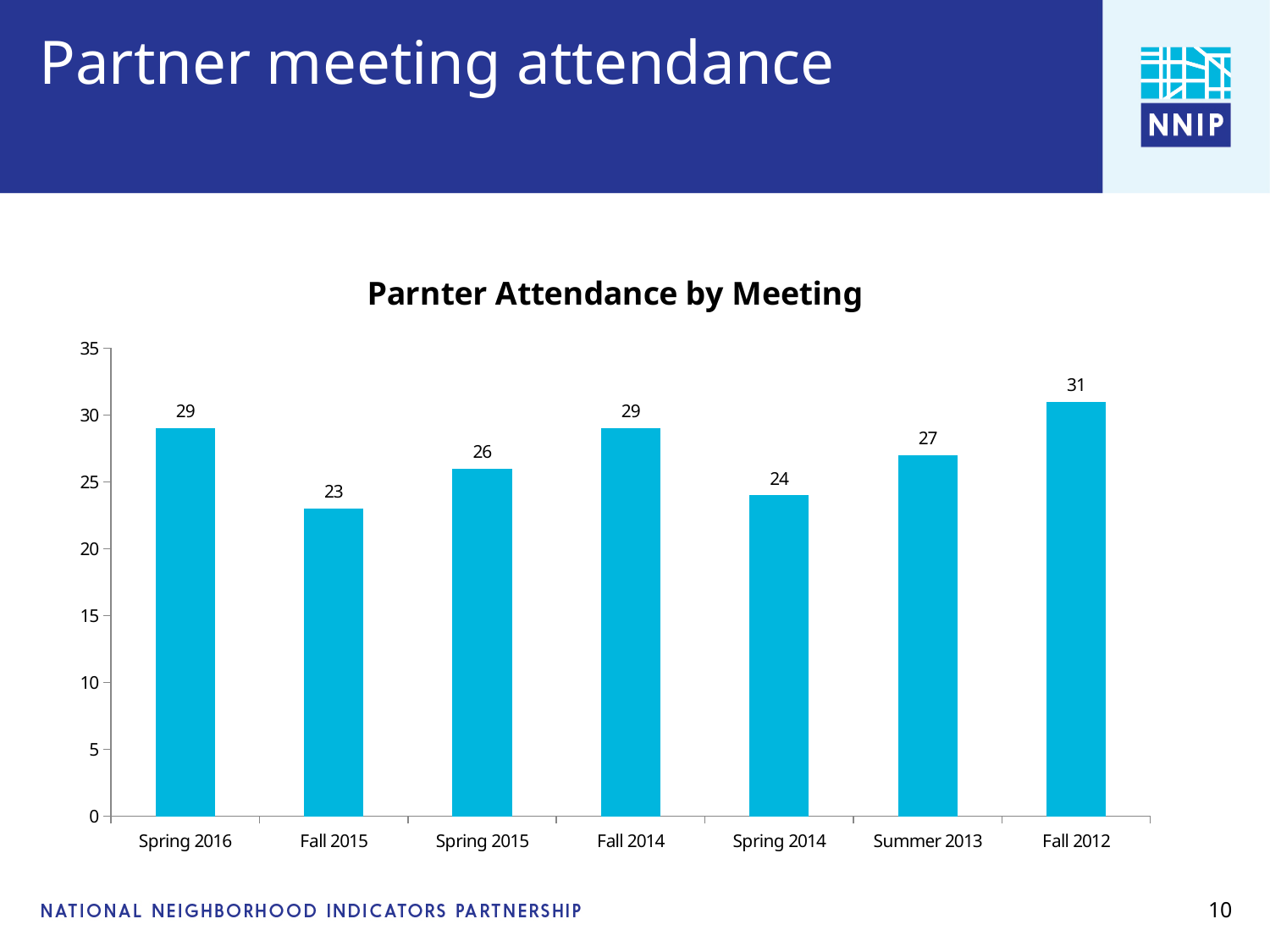
What is the partner attendance for Fall 2015? 23 What is the title of the chart? Parnter Attendance by Meeting What is the difference in attendance between Fall 2012 and Fall 2015? 8 What is the difference in attendance between Spring 2015 and Spring 2014? 2 What is the partner attendance for Spring 2016? 29 Is the attendance for Spring 2014 greater or less than 25? less What kind of chart is shown on the slide? bar chart Which meeting had higher attendance, Spring 2015 or Summer 2013? Summer 2013 Which meeting has the lowest partner attendance? Fall 2015 How many meetings are shown on the chart? 7 Which meeting has the highest partner attendance? Fall 2012 What is the partner attendance for Summer 2013? 27